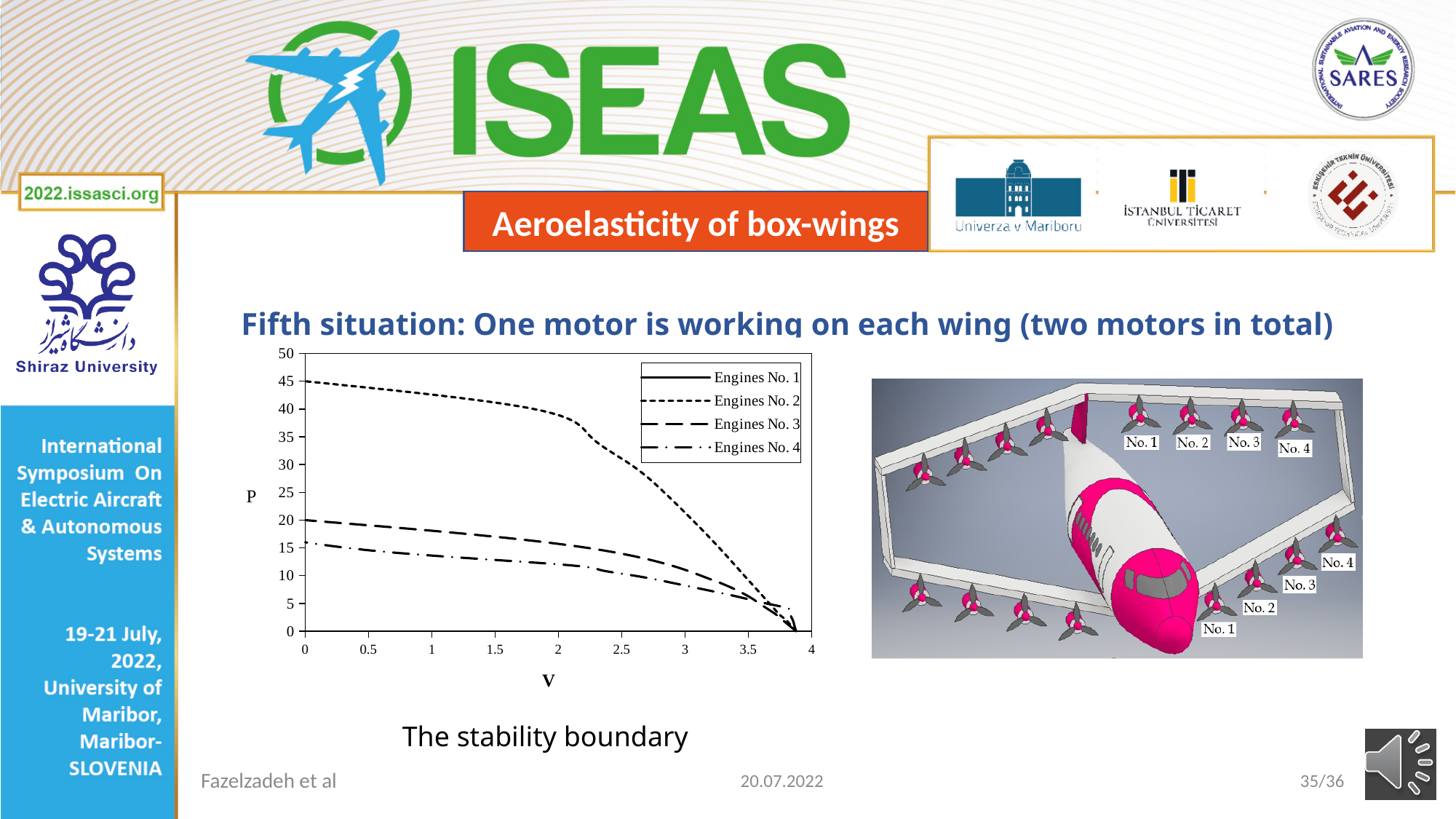
At V = 2, which series has the smaller value of P: Engines No. 3 or Engines No. 4? Engines No. 4 What kind of chart is shown on the slide? line chart Is the value of P for Engines No. 2 at V = 0 greater or less than 40? greater Is the value of P for Engines No. 4 at V = 0 greater or less than 20? less Does the value of P for Engines No. 2 rise or fall as V increases? fall How many series does the chart legend list? 4 What is the label of the horizontal axis of the chart? V What is the label of the vertical axis of the chart? P Is the value of P for Engines No. 3 at V = 1 greater or less than 15? greater At V = 0, which series has the larger value of P: Engines No. 2 or Engines No. 3? Engines No. 2 Does the value of P for Engines No. 3 rise or fall as V increases? fall